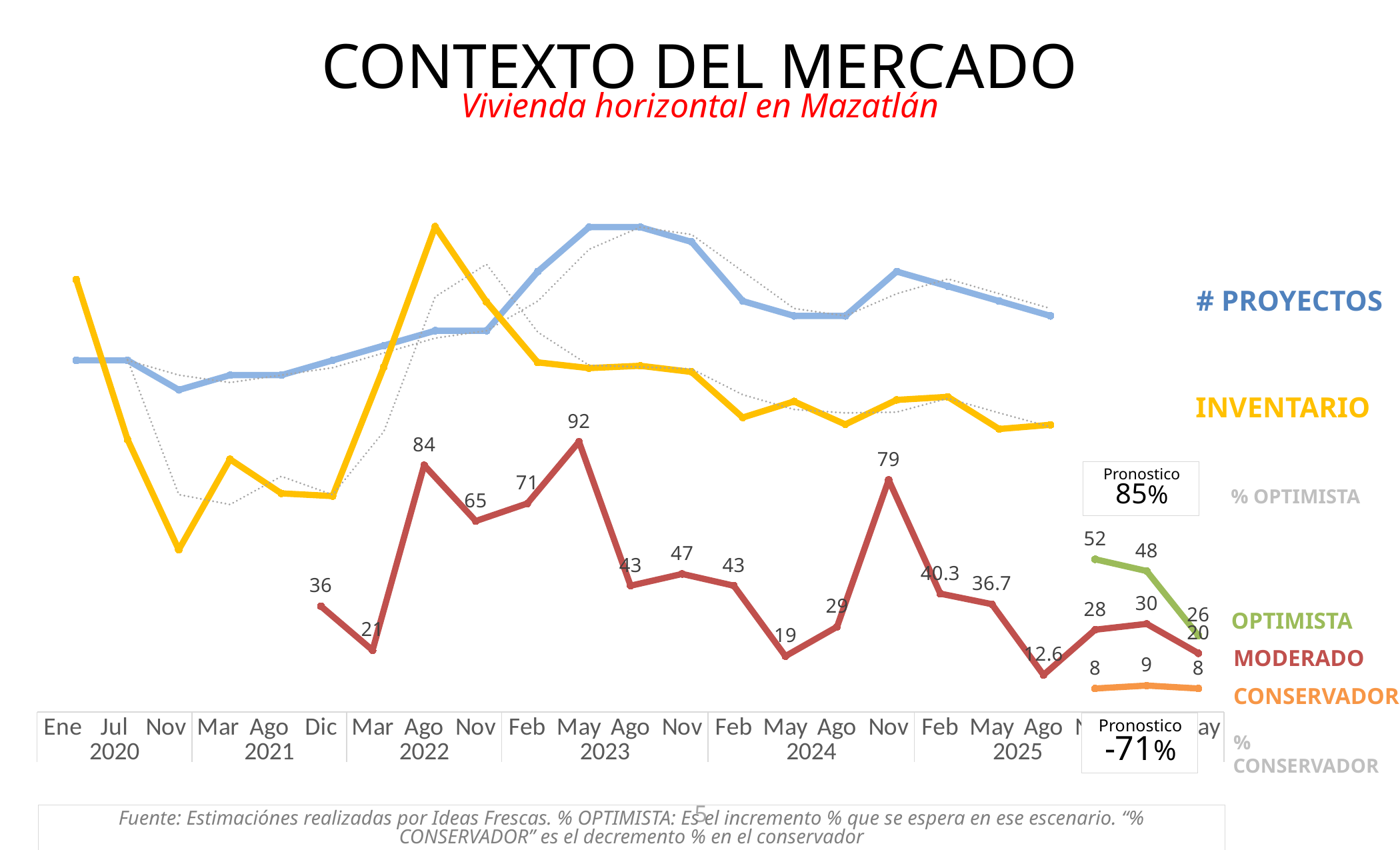
Which has the larger labelled value on the red line: Nov 2024 or Feb 2025? Nov 2024 What is the lowest value labelled on the red MODERADO line? 12.6 What is the 'Pronostico' percentage shown in the box next to % OPTIMISTA? 85% What is the highest value labelled on the red MODERADO line? 92 What kind of chart is shown on the slide? line chart What is the difference between the red line's labelled values at Nov 2023 (47) and Ago 2023 (43)? 4 What is the first labelled value on the green OPTIMISTA forecast line? 52 What is the 'Pronostico' percentage shown in the box next to % CONSERVADOR? -71% What is the value labelled on the red MODERADO line at Dic 2021? 36 What is the value labelled on the red MODERADO line at May 2023? 92 What is the red subtitle under the chart title? Vivienda horizontal en Mazatlán What is the difference between the red line's labelled values at Ago 2022 (84) and Nov 2022 (65)? 19